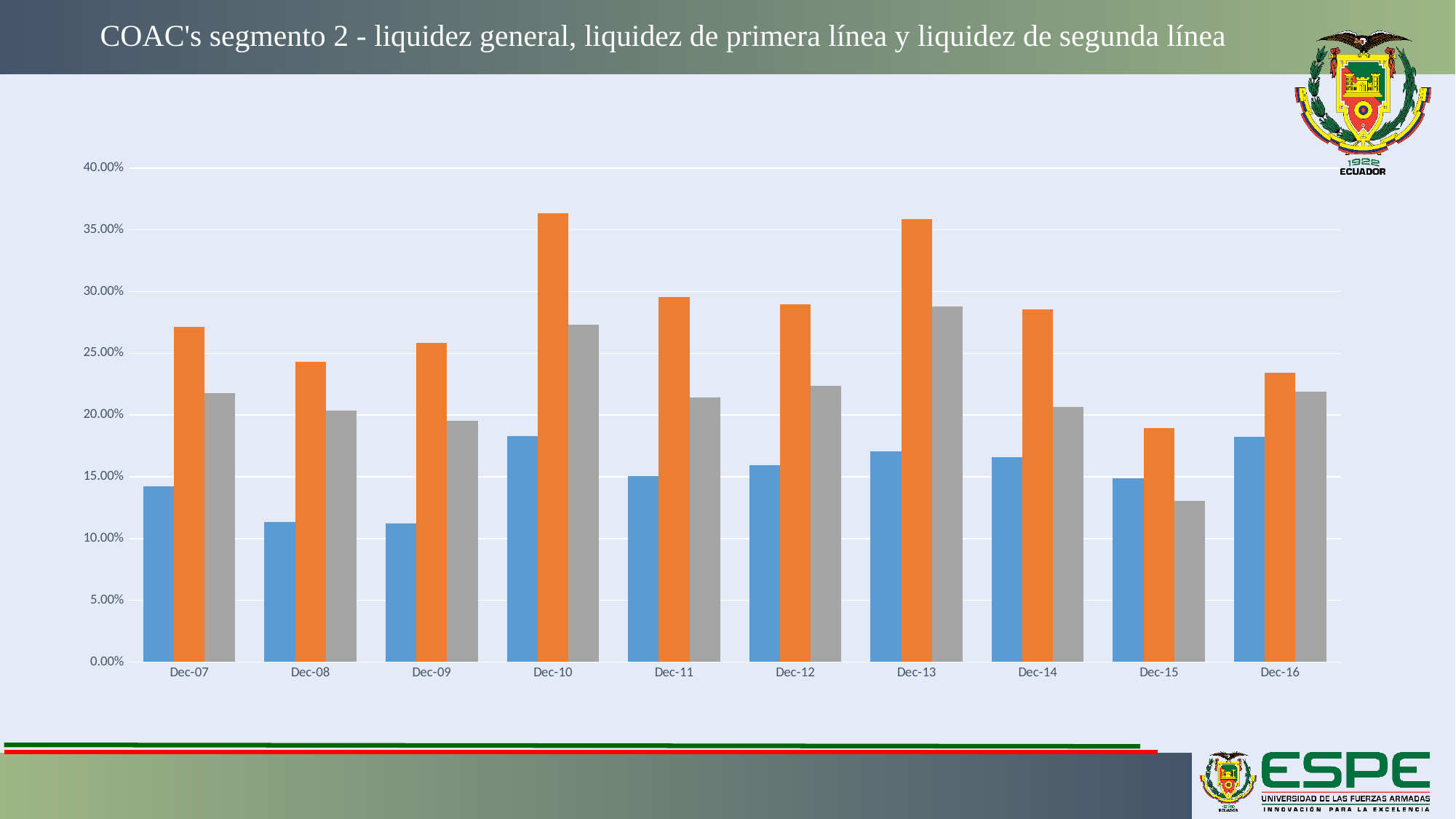
For which date is the gray bar lowest? Dec-15 Is the value of the gray bar for Dec-15 greater or less than 15.00%? less Is the value of the blue bar for Dec-10 greater or less than 15.00%? greater For which date is the orange bar lowest? Dec-15 For Dec-11, which is larger: the orange bar or the gray bar? the orange bar Is the value of the orange bar for Dec-10 greater or less than 35.00%? greater How many bars are shown for each date on the chart? 3 What kind of chart is shown on the slide? bar chart How many dates are shown along the x axis of the chart? 10 What is the title of the slide containing the chart? COAC's segmento 2 - liquidez general, liquidez de primera línea y liquidez de segunda línea